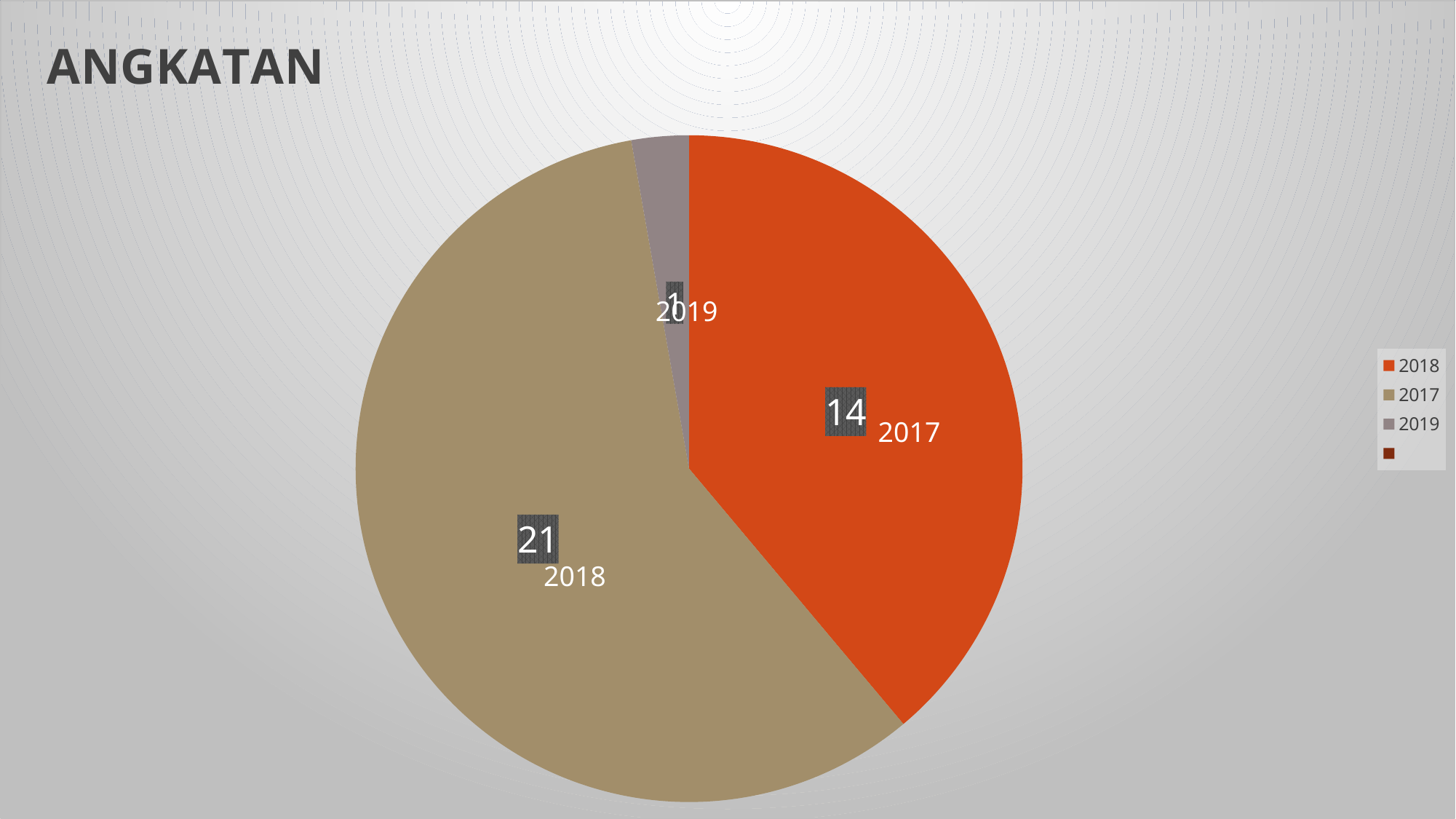
What is the difference between the tan slice (21) and the orange slice (14)? 7 What is the value of the tan (brown) slice? 21 What is the value of the orange slice? 14 What is the title of the chart? ANGKATAN What colour is the slice labelled 2019? gray Which is larger, the orange slice or the tan slice? the tan slice What is the value of the largest slice in the pie? 21 What kind of chart is shown on the slide? pie chart What is the value of the slice labelled 2019? 1 What is the value of the smallest slice in the pie? 1 How many slices does the pie chart have? 3 What is the total of all slice values in the pie? 36